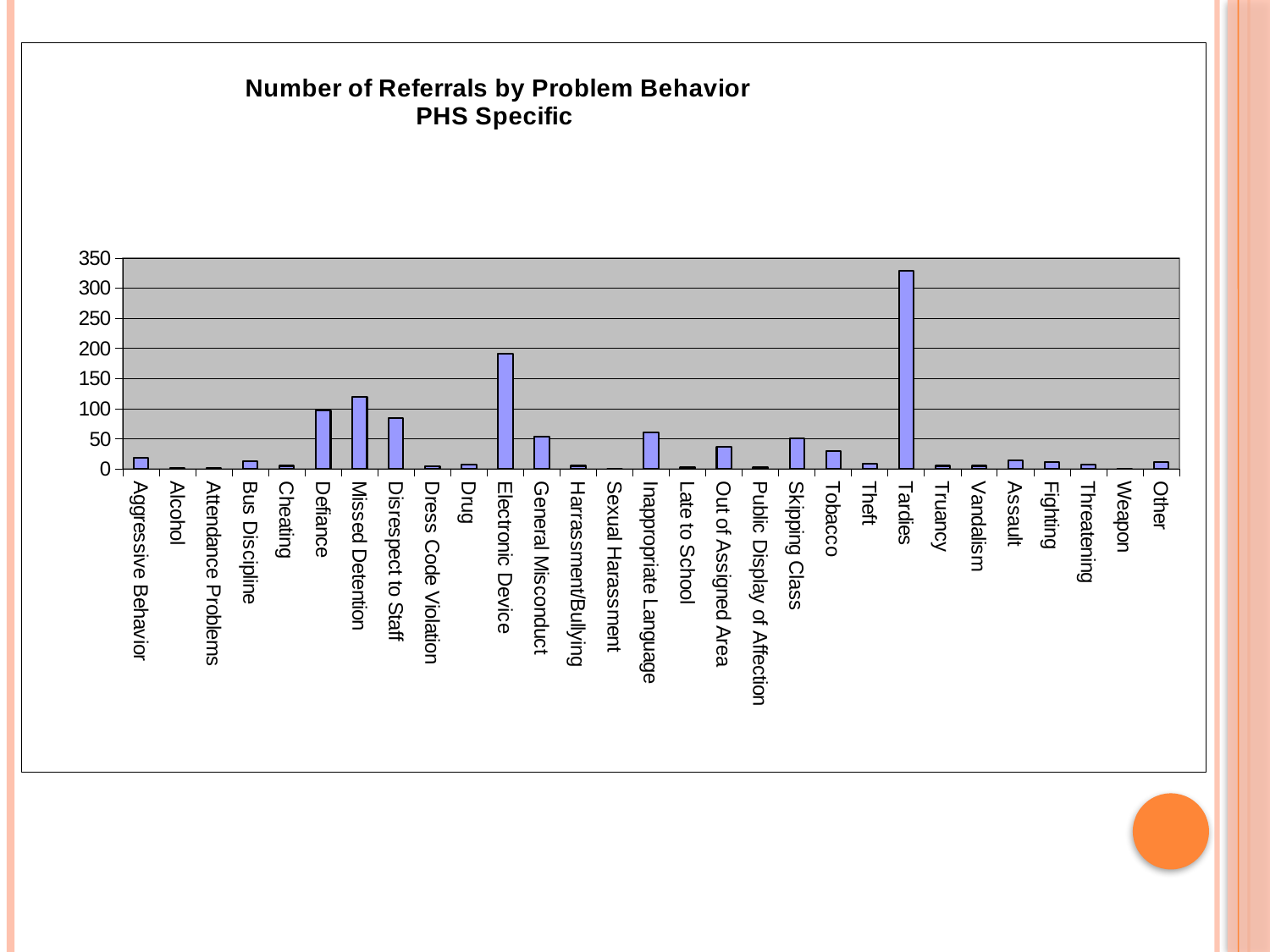
Which problem behavior has the highest number of referrals? Tardies Which has more referrals, Tardies or Electronic Device? Tardies What kind of chart is shown on the slide? bar chart Is the value for Missed Detention greater or less than 100? greater Is the value for Out of Assigned Area greater or less than 50? less Is the value for Disrespect to Staff greater or less than 100? less What is the title of the chart? Number of Referrals by Problem Behavior PHS Specific How many problem behavior categories are shown on the x axis? 29 Which has more referrals, Electronic Device or Missed Detention? Electronic Device